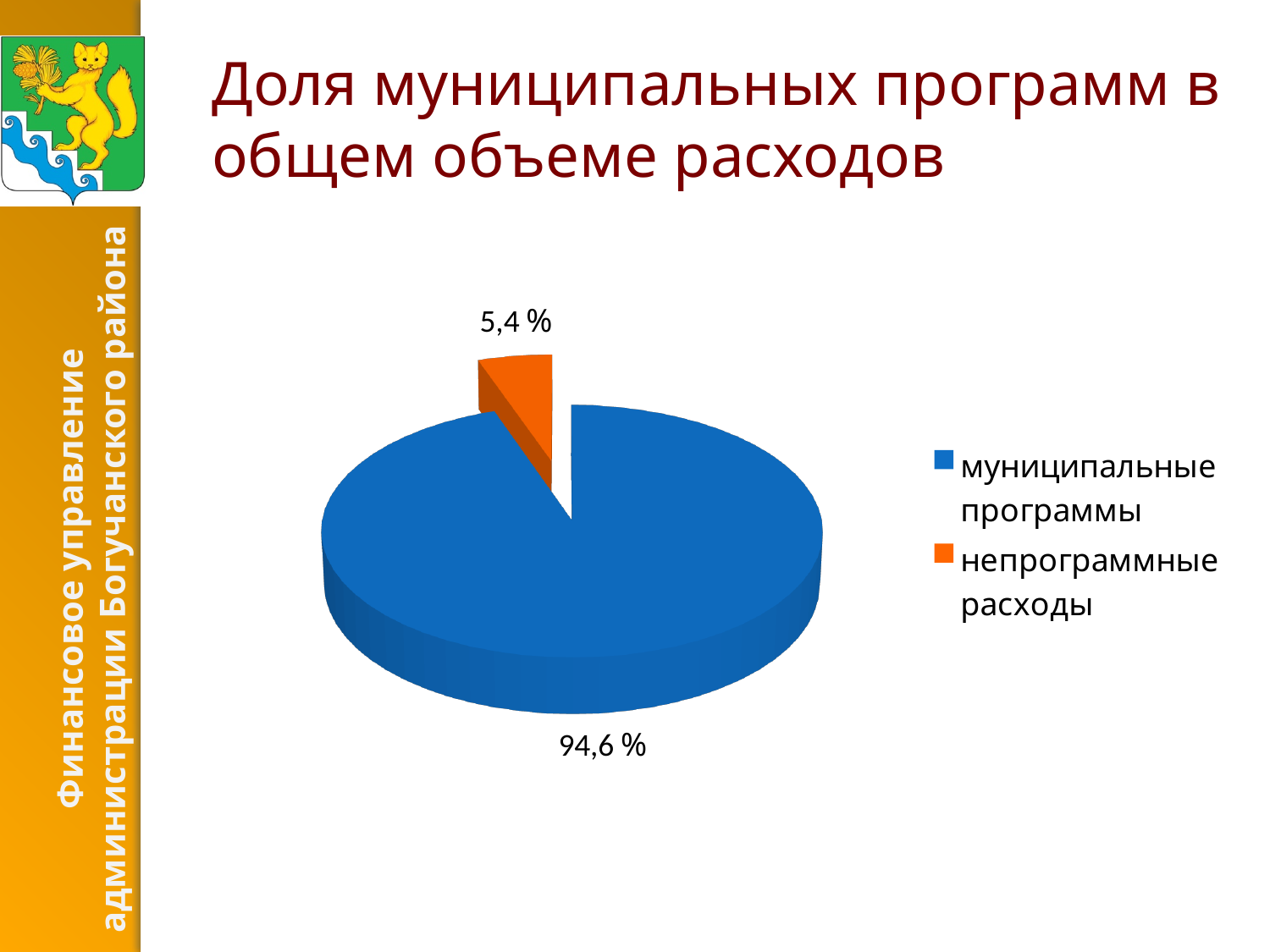
Which category has the largest slice of the pie? муниципальные программы What share of the pie does "муниципальные программы" take? 94,6 % What share of the pie does "непрограммные расходы" take? 5,4 % How many entries does the legend list? 2 What kind of chart is shown on the slide? pie chart Which category has the smallest slice of the pie? непрограммные расходы How many slices does the pie chart have? 2 Which is larger: the slice for "муниципальные программы" or the slice for "непрограммные расходы"? муниципальные программы What is the difference in percentage points between the "муниципальные программы" slice and the "непрограммные расходы" slice? 89,2 What colour is the slice for "непрограммные расходы"? orange What is the title of the slide containing the chart? Доля муниципальных программ в общем объеме расходов